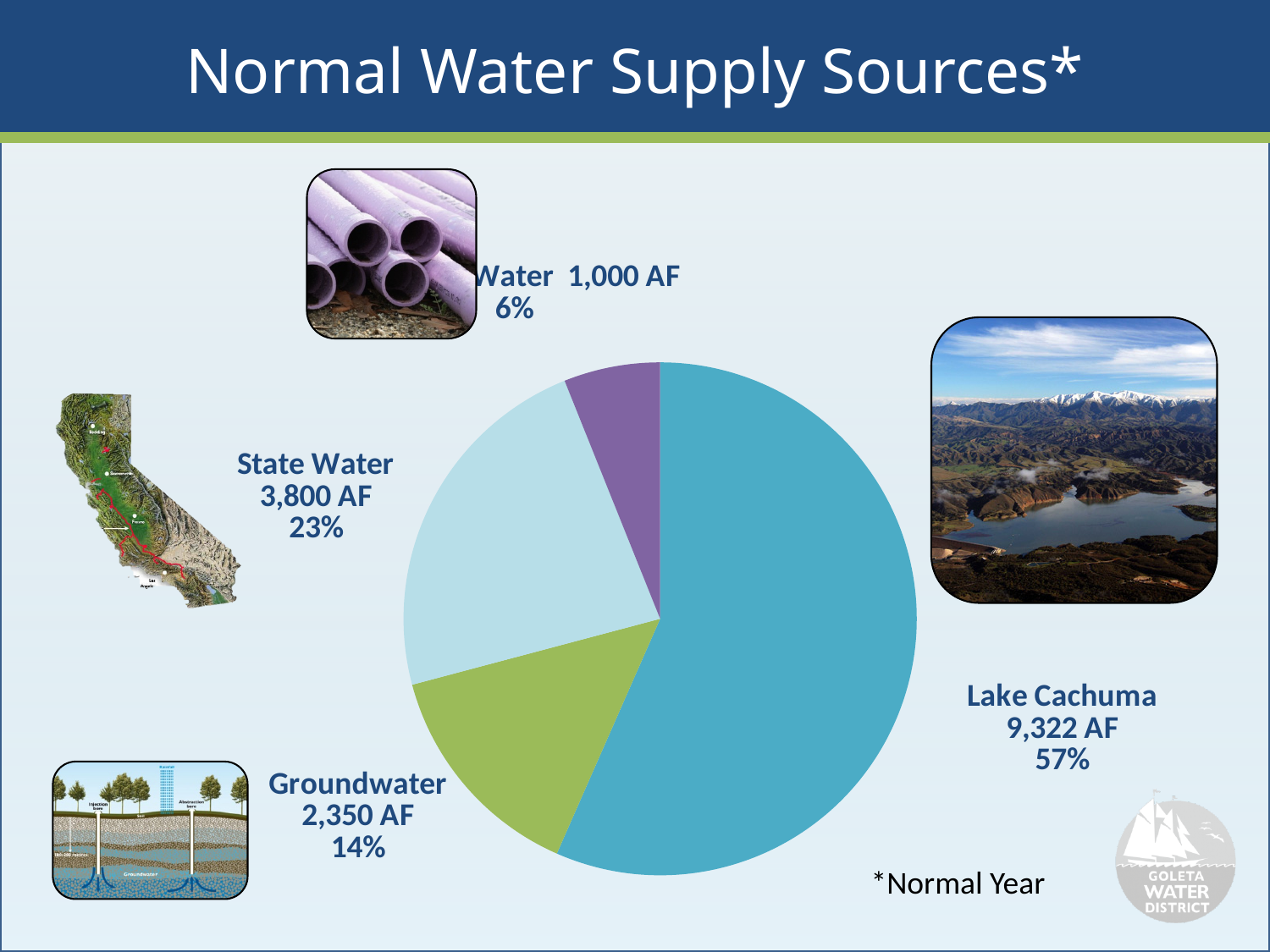
What is the value shown for the purple slice of the pie chart? 1,000 AF How many acre-feet come from Groundwater? 2,350 AF How many slices does the pie chart have? 4 How many acre-feet does Lake Cachuma supply in a normal year? 9,322 AF Which is larger, State Water or Groundwater? State Water What is the title of the slide containing the pie chart? Normal Water Supply Sources* What kind of chart is shown on the slide? pie chart What share of the pie does Lake Cachuma represent? 57% What percentage of the normal water supply comes from State Water? 23% Which water supply source is the largest? Lake Cachuma What is the difference in acre-feet between Lake Cachuma and State Water? 5,522 AF What is the difference in acre-feet between State Water and Groundwater? 1,450 AF